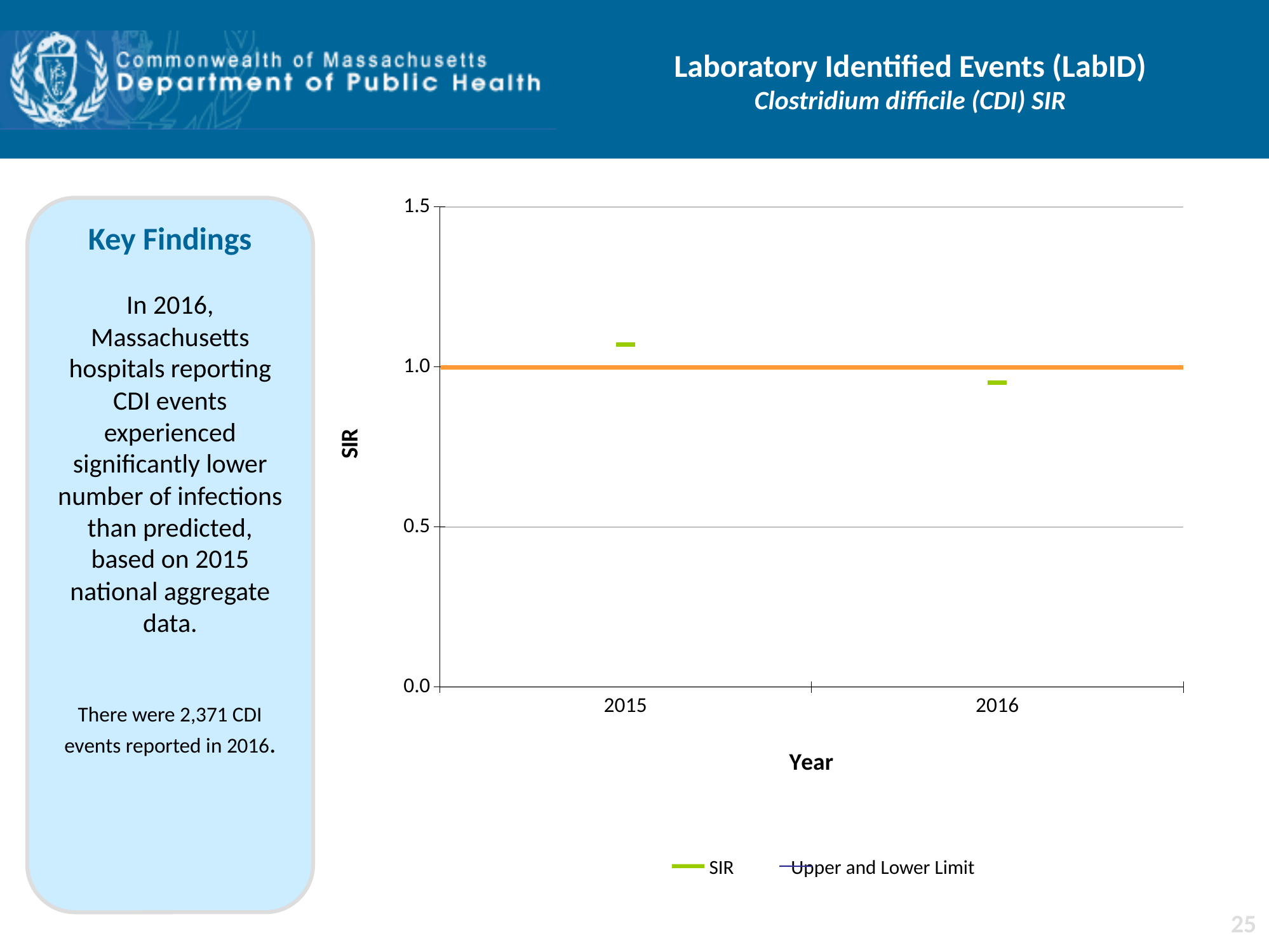
Is the SIR value larger in 2015 or in 2016? 2015 How many years are shown on the x axis? 2 Does the SIR value rise or fall from 2015 to 2016? fall Which year has the higher SIR value? 2015 Is the SIR value for 2015 greater or less than 1.0? greater What are the two entries listed in the legend? SIR; Upper and Lower Limit Is the SIR value for 2016 greater or less than 0.5? greater What kind of chart is shown on the slide? line chart What is the title of the y axis? SIR How many series does the legend list? 2 Which year has the lower SIR value? 2016 Is the SIR value for 2016 greater or less than 1.0? less